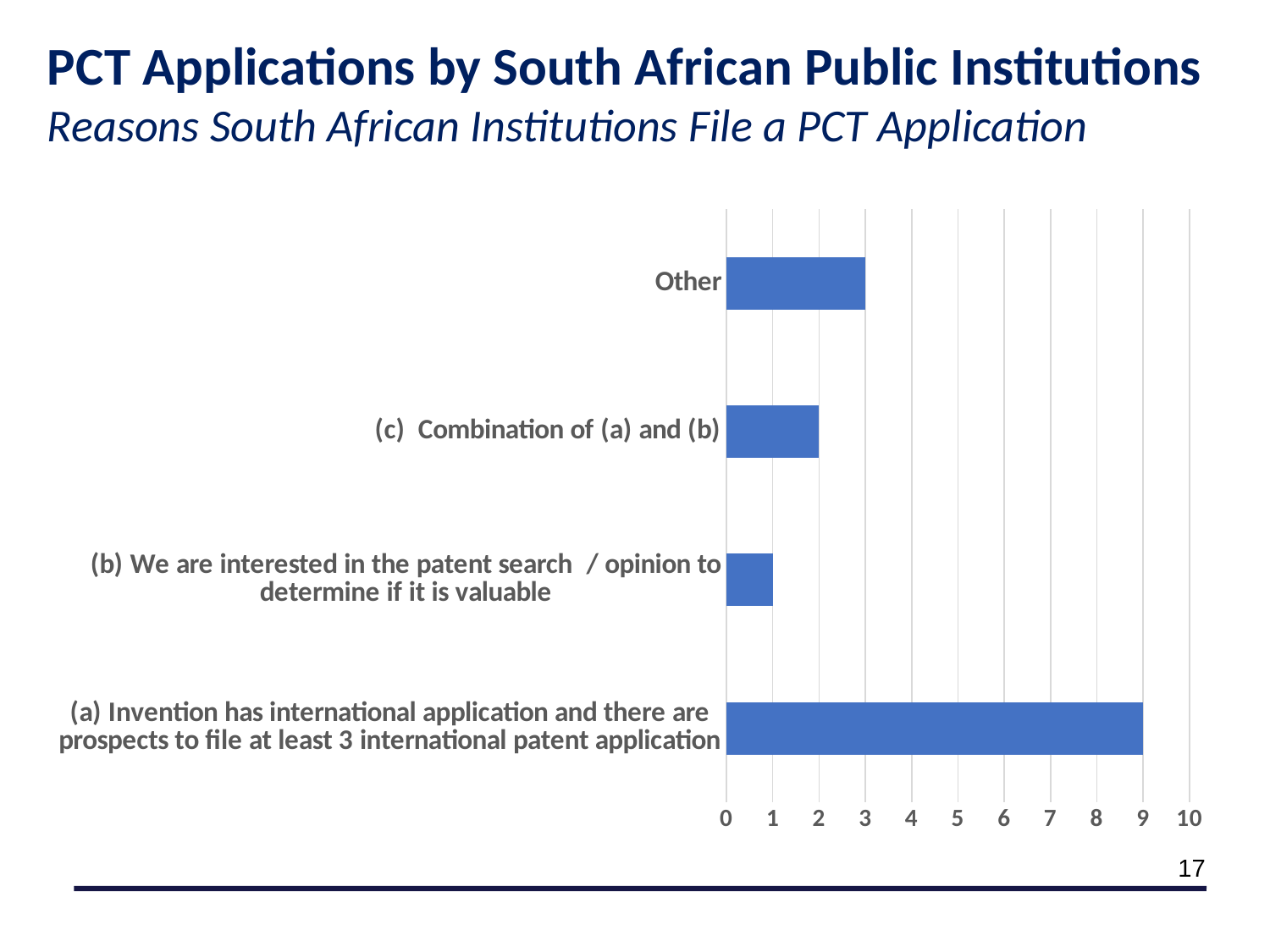
Is the value for reason (a) greater or less than 5? greater How many categories (reasons) are plotted in the chart? 4 Which is larger: the value for "Other" or the value for "(c) Combination of (a) and (b)"? Other What is the maximum value shown on the horizontal axis? 10 What is the value for "(a) Invention has international application and there are prospects to file at least 3 international patent application"? 9 What is the value for "(c) Combination of (a) and (b)"? 2 What is the value for "(b) We are interested in the patent search / opinion to determine if it is valuable"? 1 What is the value for "Other"? 3 What kind of chart is shown on the slide? Bar chart What is the difference between the value for reason (a) and the value for "Other"? 6 Which reason has the highest value? (a) Invention has international application and there are prospects to file at least 3 international patent application Which reason has the lowest value? (b) We are interested in the patent search / opinion to determine if it is valuable